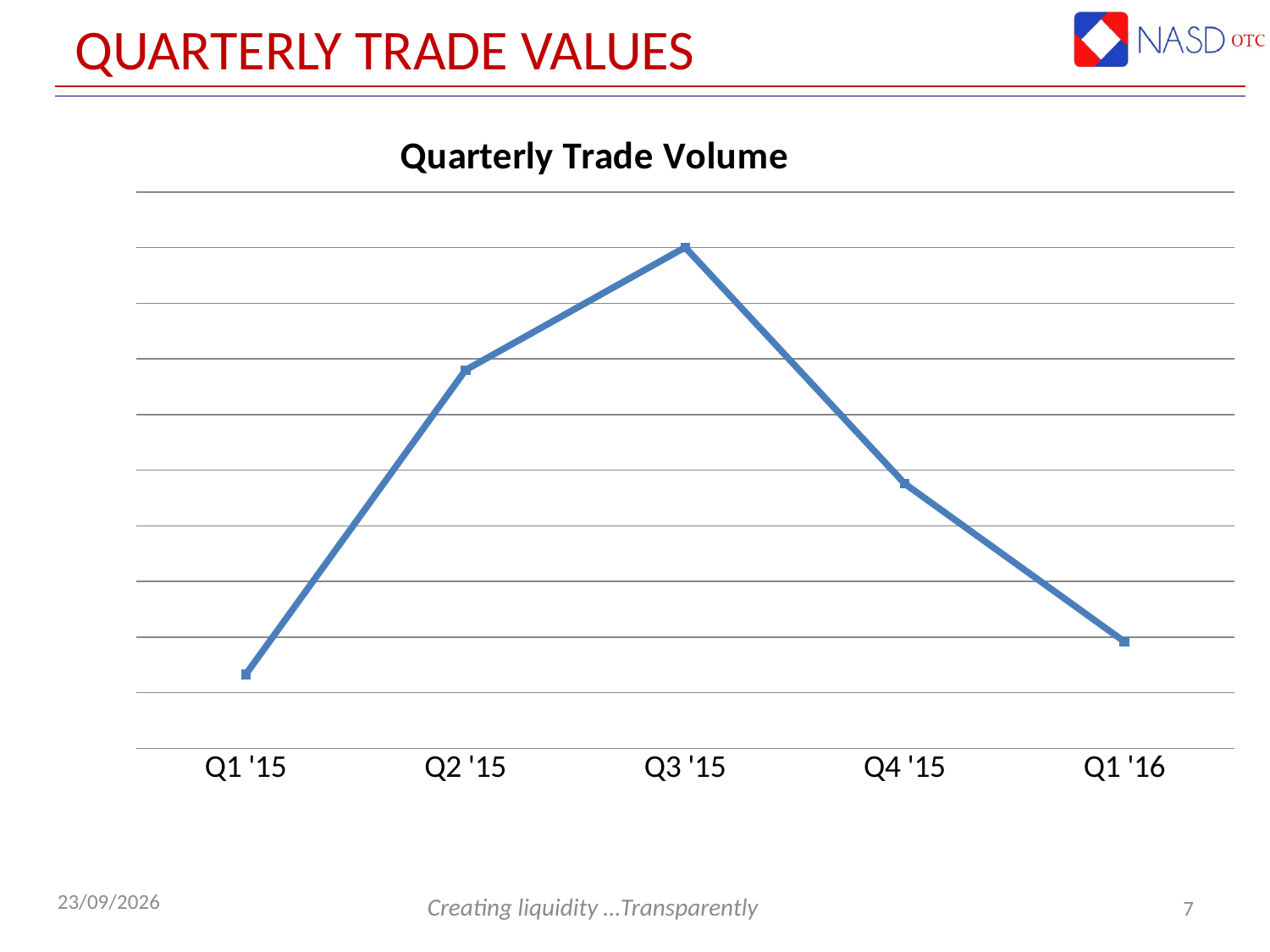
What is the first quarter shown on the x axis? Q1 '15 What is the title of the chart? Quarterly Trade Volume Which is higher, the trade volume for Q1 '15 or Q1 '16? Q1 '16 Does the trade volume rise or fall from Q3 '15 to Q1 '16? Fall Which quarter has the highest trade volume? Q3 '15 Which is higher, the trade volume for Q2 '15 or Q4 '15? Q2 '15 Does the trade volume rise or fall from Q1 '15 to Q3 '15? Rise How many quarters are plotted on the x axis? 5 What kind of chart is shown on the slide? Line chart Which is higher, the trade volume for Q4 '15 or Q1 '16? Q4 '15 Which quarter has the lowest trade volume? Q1 '15